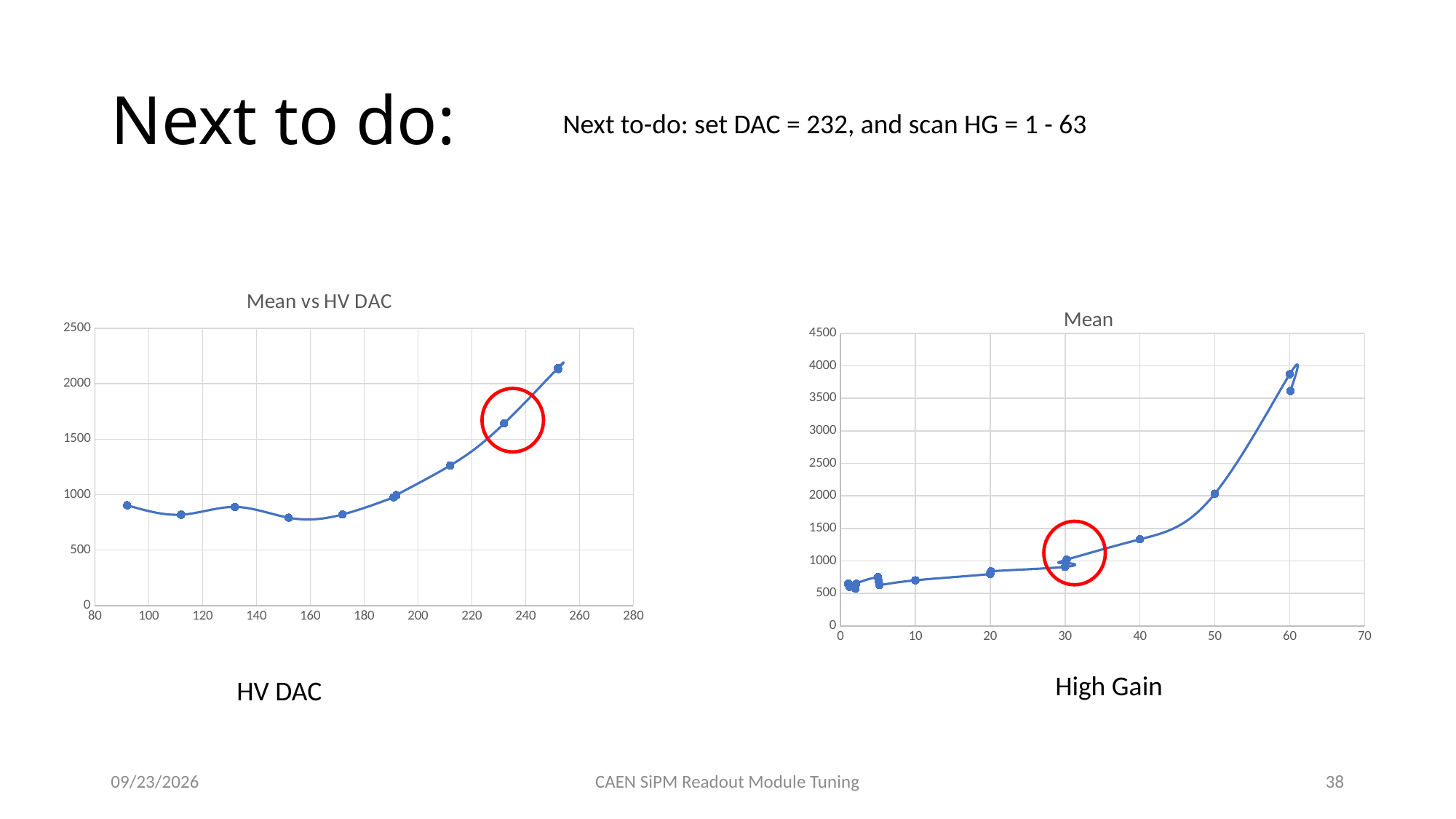
What is the maximum value shown on the y axis of the right chart "Mean"? 4500 In the left chart "Mean vs HV DAC", do the values rise or fall between HV DAC 172 and 252? rise In the left chart "Mean vs HV DAC", is the value at HV DAC 92 greater or less than 1000? less In the left chart "Mean vs HV DAC", is the value at HV DAC 252 greater or less than 2000? greater In the right chart "Mean", is the value at High Gain 40 greater or less than 1000? greater In the right chart "Mean", which is larger, the value at High Gain 50 or the value at High Gain 40? High Gain 50 In the left chart "Mean vs HV DAC", at which HV DAC value is the mean highest? 252 What kind of chart is the left chart titled "Mean vs HV DAC"? line chart What is the title of the right chart? Mean